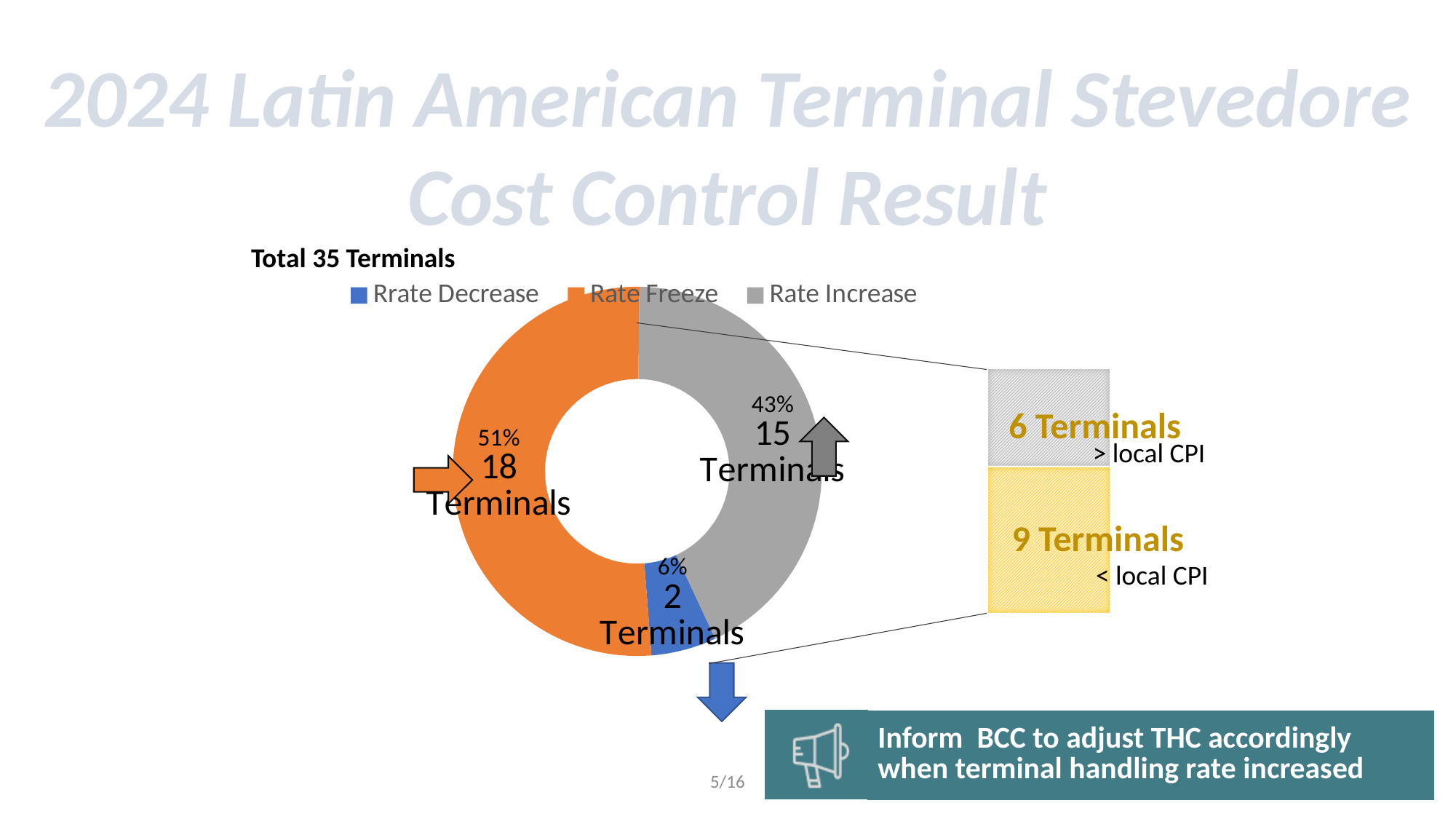
What share of the chart does Rate Freeze represent? 51% What kind of chart is shown on the slide? Doughnut (pie) chart What share of the chart does Rate Increase represent? 43% How many terminals are in the Rate Decrease category? 2 Terminals How many categories does the chart legend list? 3 What is the title of the chart? Total 35 Terminals Which colour represents Rate Increase in the chart? Grey How many terminals are in the Rate Increase category? 15 Terminals Which category has the largest share of the chart? Rate Freeze What is the difference in the number of terminals between Rate Freeze and Rate Increase? 3 How many terminals are in the Rate Freeze category? 18 Terminals Which category has the smallest share of the chart? Rate Decrease